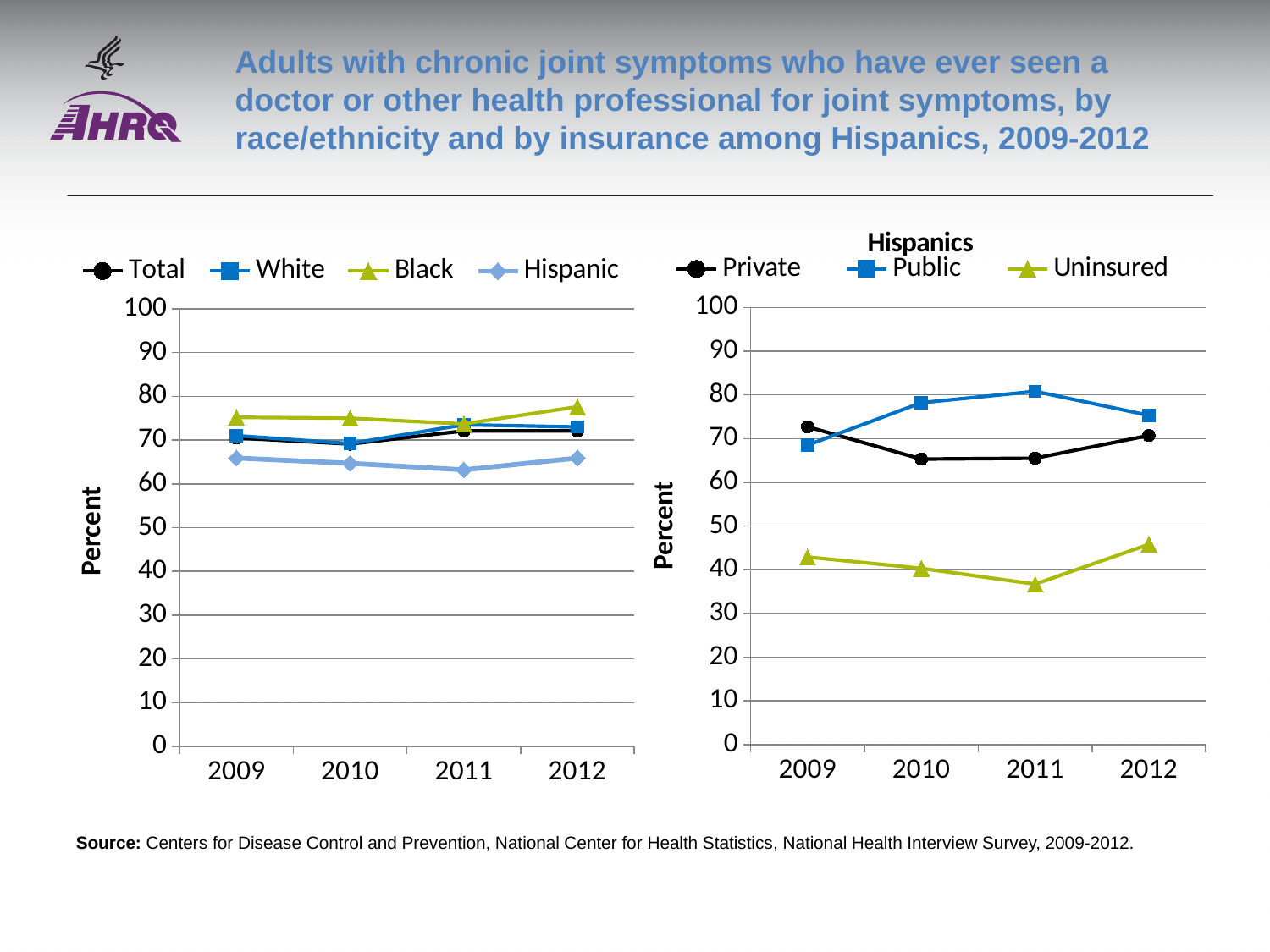
What kind of chart is the left chart showing race/ethnicity groups? line chart In the left chart, which group has the lowest value in 2011? Hispanic How many series does the legend of the right chart titled Hispanics list? 3 In the left chart, is the value for Hispanic in 2011 greater or less than 70? less In the right chart titled Hispanics, does the Uninsured line rise or fall from 2011 to 2012? rise In the left chart, which group has the highest value in 2009? Black In the right chart titled Hispanics, which insurance group has the highest value in 2011? Public In the right chart titled Hispanics, is the value for Uninsured in 2011 greater or less than 40? less How many series does the legend of the left chart (Total, White, Black, Hispanic) list? 4 In the right chart titled Hispanics, which insurance group has the lowest value in 2010? Uninsured How many years are shown on the x axis of the right chart titled Hispanics? 4 In the right chart titled Hispanics, which is larger in 2010, Private or Public? Public